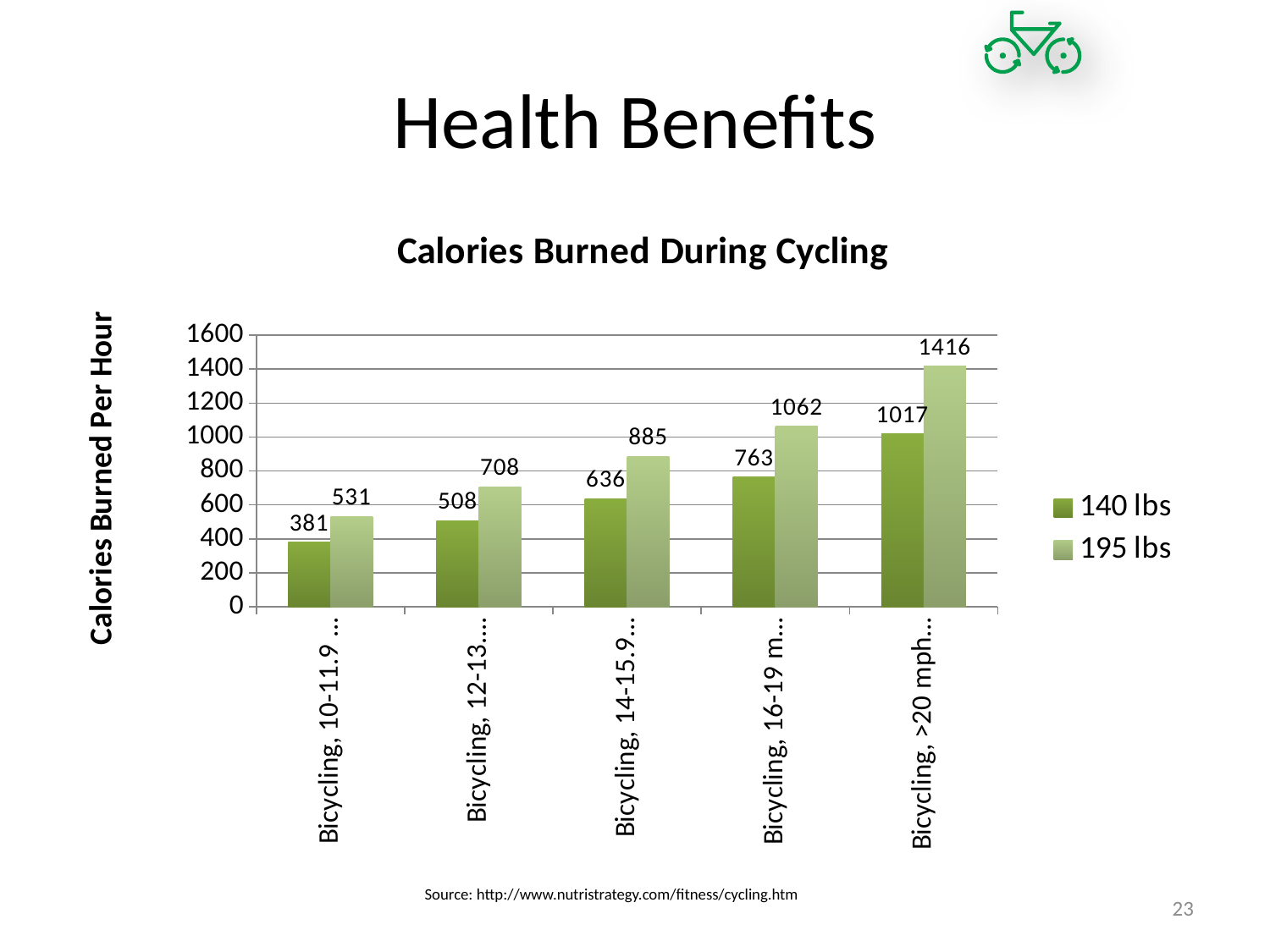
Do the 140 lbs values rise or fall from left to right along the x axis? Rise What is the title of the chart? Calories Burned During Cycling What is the value for 140 lbs in the "Bicycling, >20 mph" category? 1017 What is the value for 195 lbs in the "Bicycling, 14-15.9" category? 885 How many categories are shown on the x axis? 5 Which category has the highest value for the 195 lbs series? Bicycling, >20 mph What kind of chart is shown on the slide? Bar chart Which category has the lowest value for the 140 lbs series? Bicycling, 10-11.9 Which is larger in the "Bicycling, 12-13" category: the 140 lbs value or the 195 lbs value? 195 lbs What is the difference between the 195 lbs and 140 lbs values in the "Bicycling, 16-19 mph" category? 299 What is the value for 140 lbs in the "Bicycling, 10-11.9" category? 381 How many series does the legend list? 2